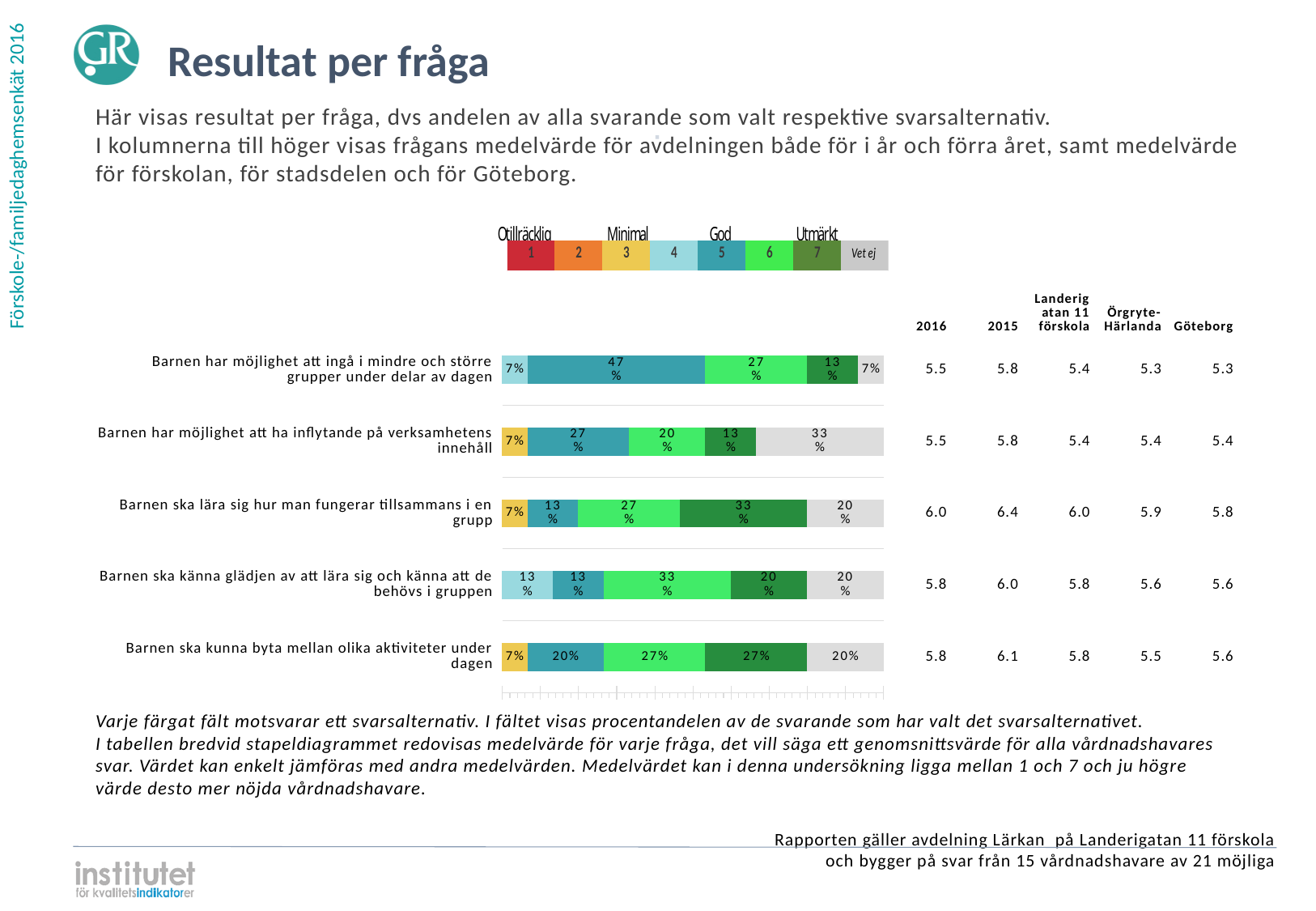
What is the 2016 mean value shown for 'Barnen ska lära sig hur man fungerar tillsammans i en grupp'? 6.0 For 'Barnen ska kunna byta mellan olika aktiviteter under dagen', what is the difference between the option 6 share and the option 5 share? 7% What percentage chose option 7 (dark green) for 'Barnen ska lära sig hur man fungerar tillsammans i en grupp'? 33% What percentage of respondents chose option 5 for 'Barnen har möjlighet att ingå i mindre och större grupper under delar av dagen'? 47% Which is larger for 'Barnen har möjlighet att ingå i mindre och större grupper under delar av dagen': the option 5 share or the option 6 share? Option 5 (47%) What is the 'Vet ej' share for 'Barnen har möjlighet att ha inflytande på verksamhetens innehåll'? 33% How many questions (categories) are shown in the bar chart? 5 How many response options does the legend above the chart list, including 'Vet ej'? 8 Which question has the largest 'Vet ej' share? Barnen har möjlighet att ha inflytande på verksamhetens innehåll What percentage chose option 6 (light green) for 'Barnen ska känna glädjen av att lära sig och känna att de behövs i gruppen'? 33% What kind of chart is used to show the results per question? Stacked bar chart